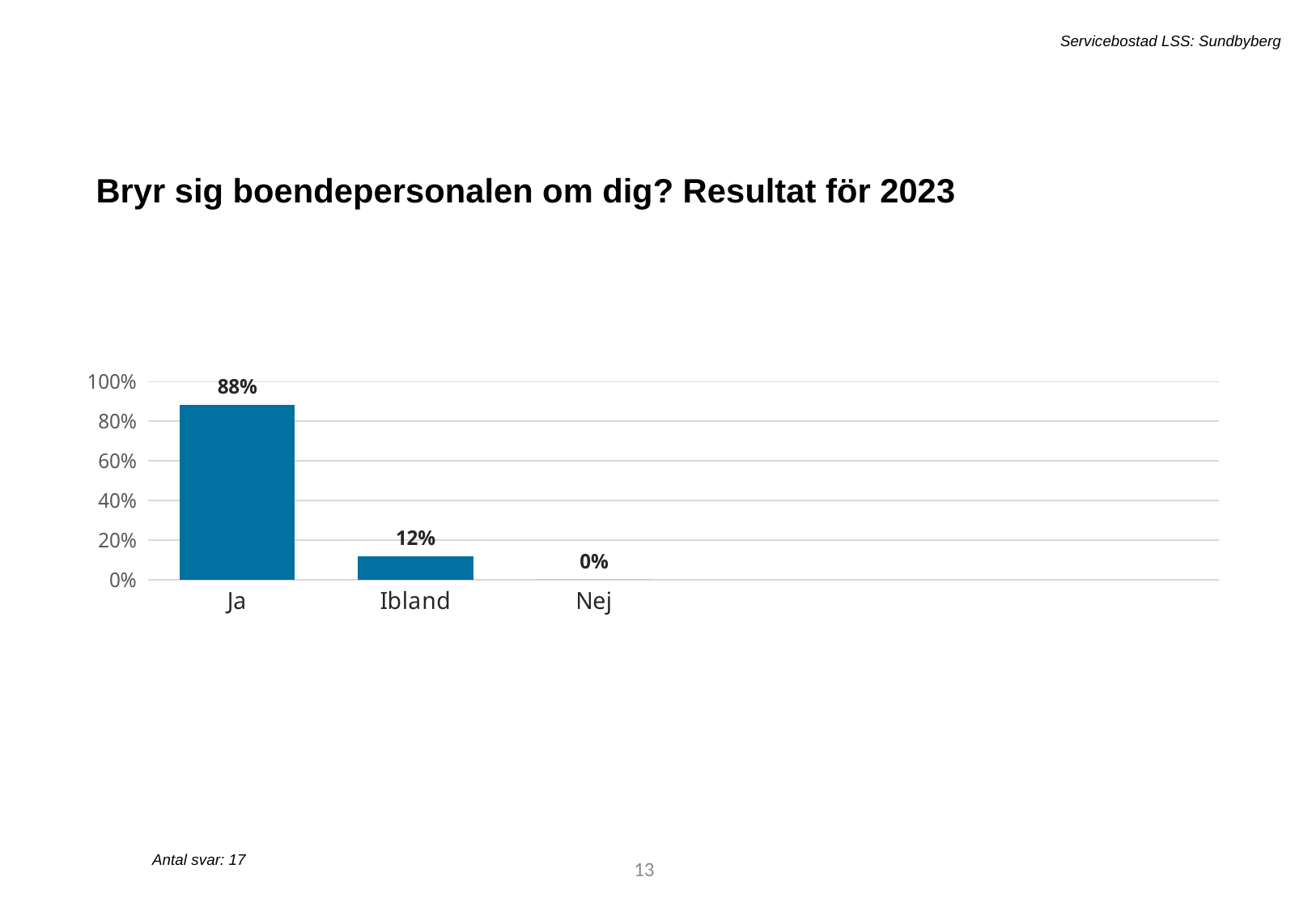
What is the value for Ibland? 12% Do the values rise or fall from left to right along the x axis? fall How many categories are shown on the x axis? 3 What is the value for Nej? 0% Which category has the lowest value? Nej Which is larger, the value for Ibland or the value for Nej? Ibland Which category has the highest value? Ja What kind of chart is shown on the slide? bar chart What is the value for Ja? 88% Is the value for Ja greater or less than 80%? greater What is the difference between the values for Ja and Ibland? 76% What is the title of the chart? Bryr sig boendepersonalen om dig? Resultat för 2023